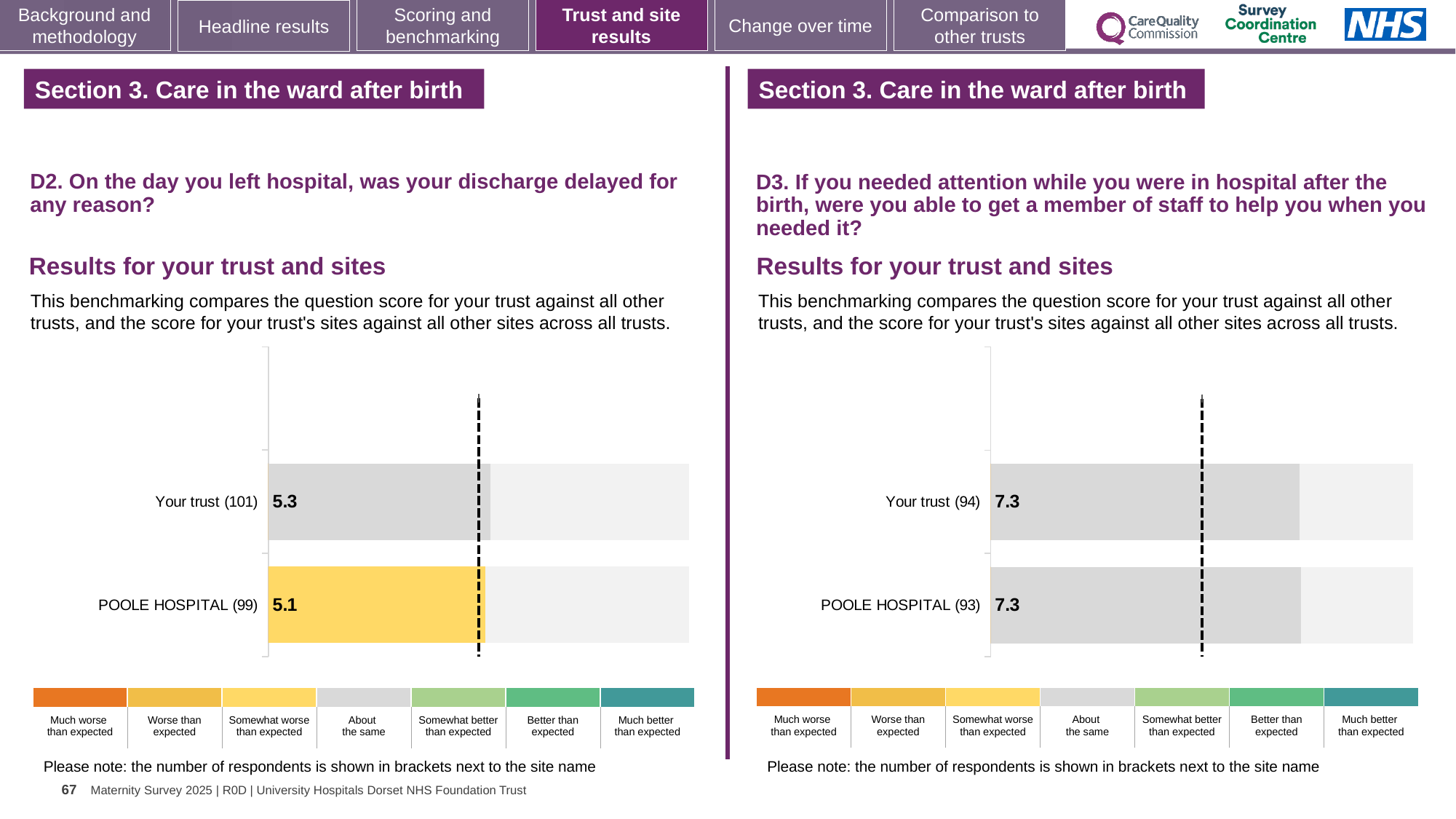
In the D3 chart (right), what is the score for Your trust? 7.3 How many bars are plotted in the D2 chart (left)? 2 In the D3 chart (right), what is the difference between the Your trust score and the POOLE HOSPITAL score? 0 What kind of chart is used in the D3 chart (right)? Bar chart In the D2 chart (left), which bar has the lowest score? POOLE HOSPITAL In the D2 chart (left), how many respondents are shown in brackets for POOLE HOSPITAL? 99 In the D3 chart (right), what is the score for POOLE HOSPITAL? 7.3 In the D2 chart (left), what is the score for POOLE HOSPITAL? 5.1 In the D2 chart (left), what is the score for Your trust? 5.3 In the D2 chart (left), what is the difference between the Your trust score and the POOLE HOSPITAL score? 0.2 In the D2 chart (left), which has the higher score, Your trust or POOLE HOSPITAL? Your trust In the D3 chart (right), how many respondents are shown in brackets for Your trust? 94